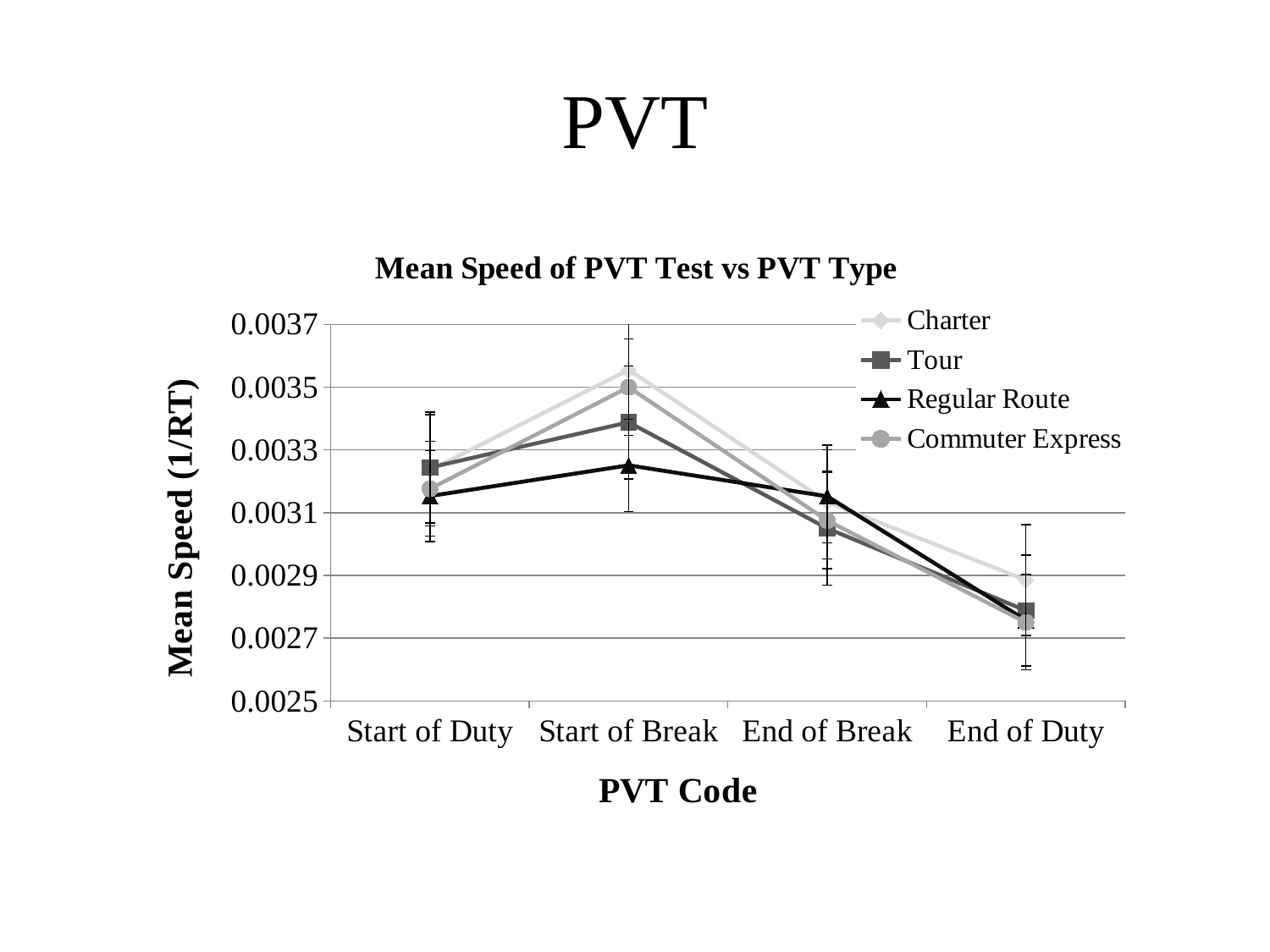
What kind of chart is shown on the slide? line chart Is the value for Charter at Start of Break greater or less than 0.0035? greater Which is larger at Start of Duty, the Tour value or the Regular Route value? Tour How many PVT Code categories are shown on the x axis? 4 What is the label of the y axis? Mean Speed (1/RT) Which series has the lowest value at Start of Break? Regular Route At which PVT Code does the Charter series reach its highest value? Start of Break How many series does the legend list? 4 What is the title of the chart? Mean Speed of PVT Test vs PVT Type Do the values for the Commuter Express series rise or fall from Start of Break to End of Duty? fall Is the value for Tour at End of Duty greater or less than 0.0029? less At which PVT Code does the Tour series have its lowest value? End of Duty